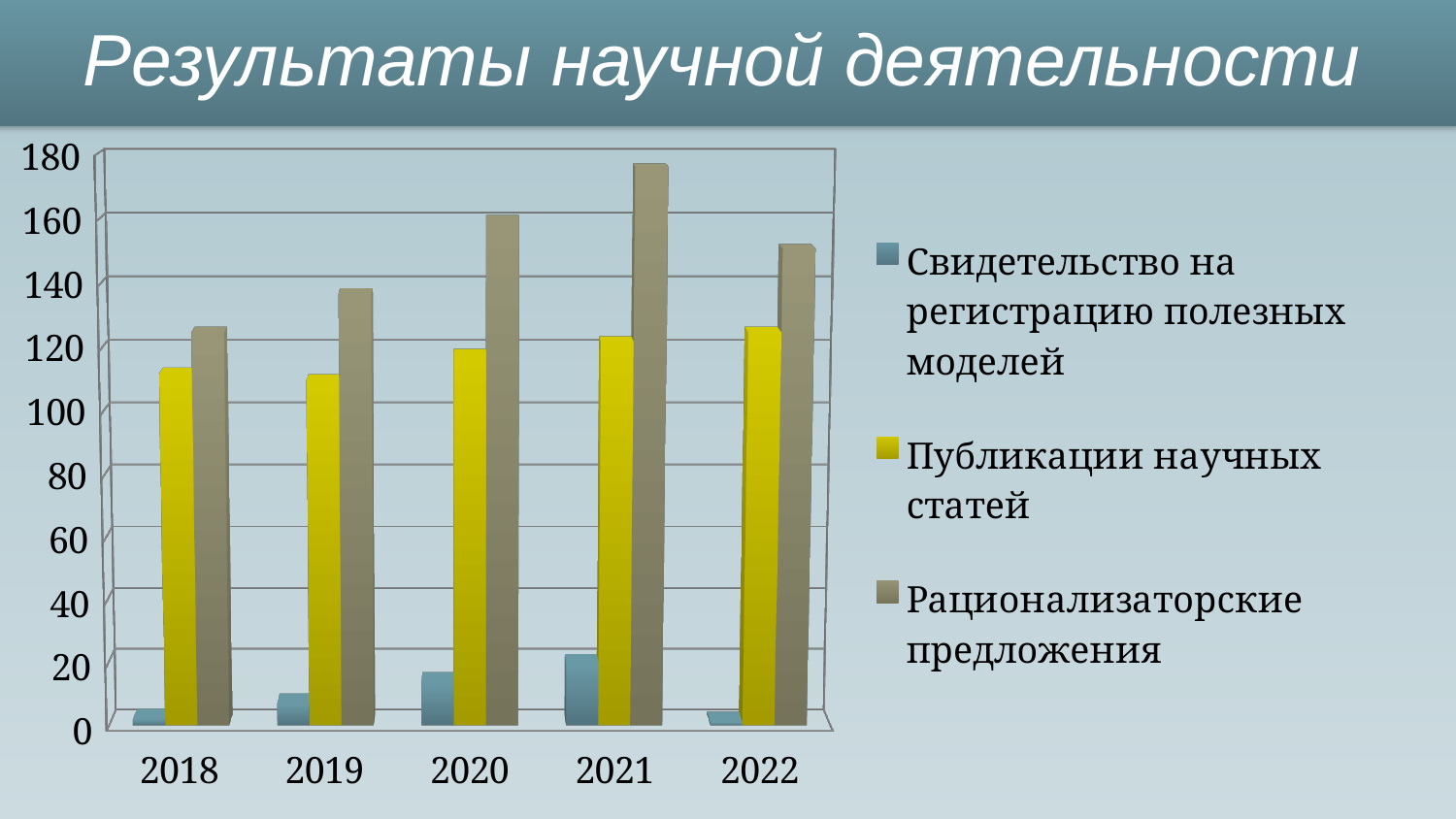
How many series does the chart legend list? 3 In which year is the value for Рационализаторские предложения lowest? 2018 Is the value for Рационализаторские предложения in 2022 greater or less than 140? greater Is the value for Свидетельство на регистрацию полезных моделей in 2021 greater or less than 40? less Is the value for Публикации научных статей in 2018 greater or less than 100? greater Between 2018 and 2021, do the values for Рационализаторские предложения rise or fall? rise In which year is the value for Свидетельство на регистрацию полезных моделей highest? 2021 In which year is the value for Рационализаторские предложения highest? 2021 How many years are shown on the x axis of the chart? 5 In 2020, which is larger: Рационализаторские предложения or Публикации научных статей? Рационализаторские предложения What kind of chart is shown on the slide? bar chart